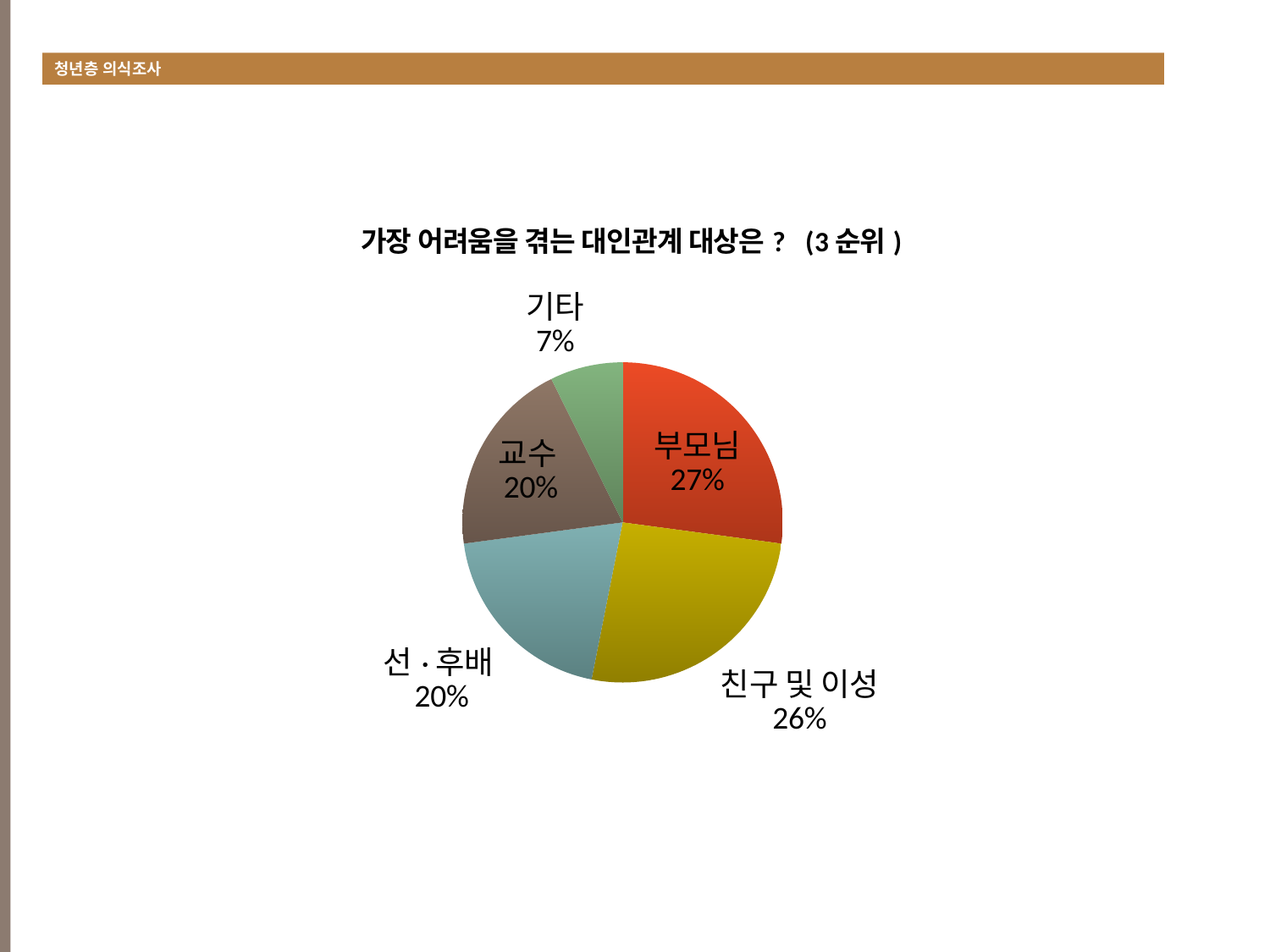
What percentage is shown for 부모님? 27% What colour is the 부모님 slice? red Which category has the smallest share of the pie? 기타 How many slices does the pie chart have? 5 What kind of chart is shown on the slide? pie chart What percentage is shown for 교수? 20% What is the difference in percentage points between 부모님 and 기타? 20 Which is larger, the share for 선·후배 or the share for 기타? 선·후배 What percentage is shown for 기타? 7% Which category has the largest share of the pie? 부모님 What percentage is shown for 친구 및 이성? 26% What is the title of the chart? 가장 어려움을 겪는 대인관계 대상은 ? (3 순위 )